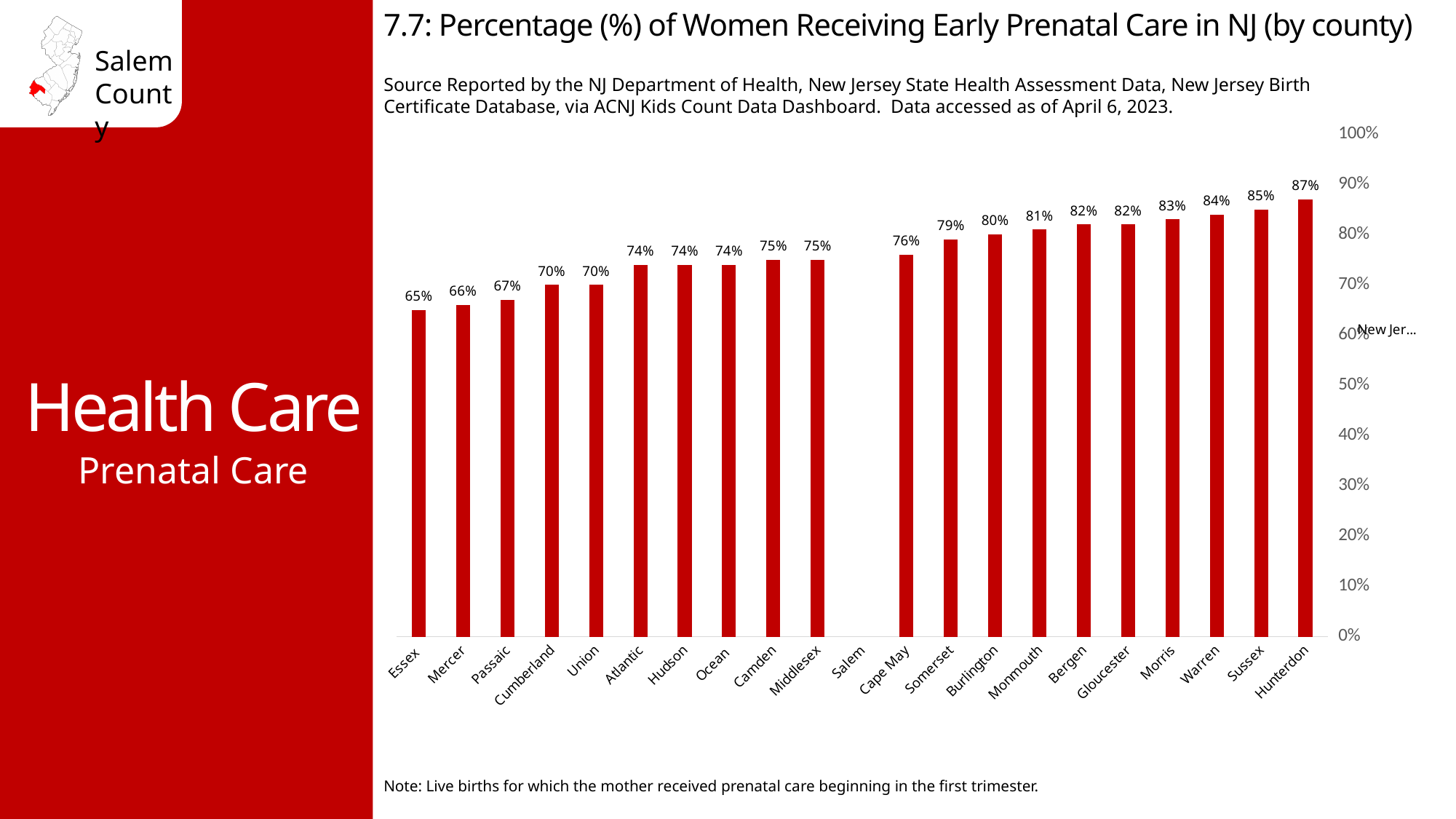
What kind of chart is shown on the slide? Bar chart What is the value shown for Cape May county? 76% What is the percentage of women receiving early prenatal care in Hunterdon county? 87% What is the difference between the values for Hunterdon and Essex? 22% What is the difference between the values for Morris and Cumberland? 13% Do the values generally rise or fall moving from left to right along the x axis? Rise What is the value shown for Essex county? 65% Which county has a higher value, Bergen or Passaic? Bergen How many counties are listed along the x axis? 21 What percentage is shown for Somerset county? 79% Which county has the lowest percentage shown on the chart? Essex Which county has the highest percentage of women receiving early prenatal care? Hunterdon